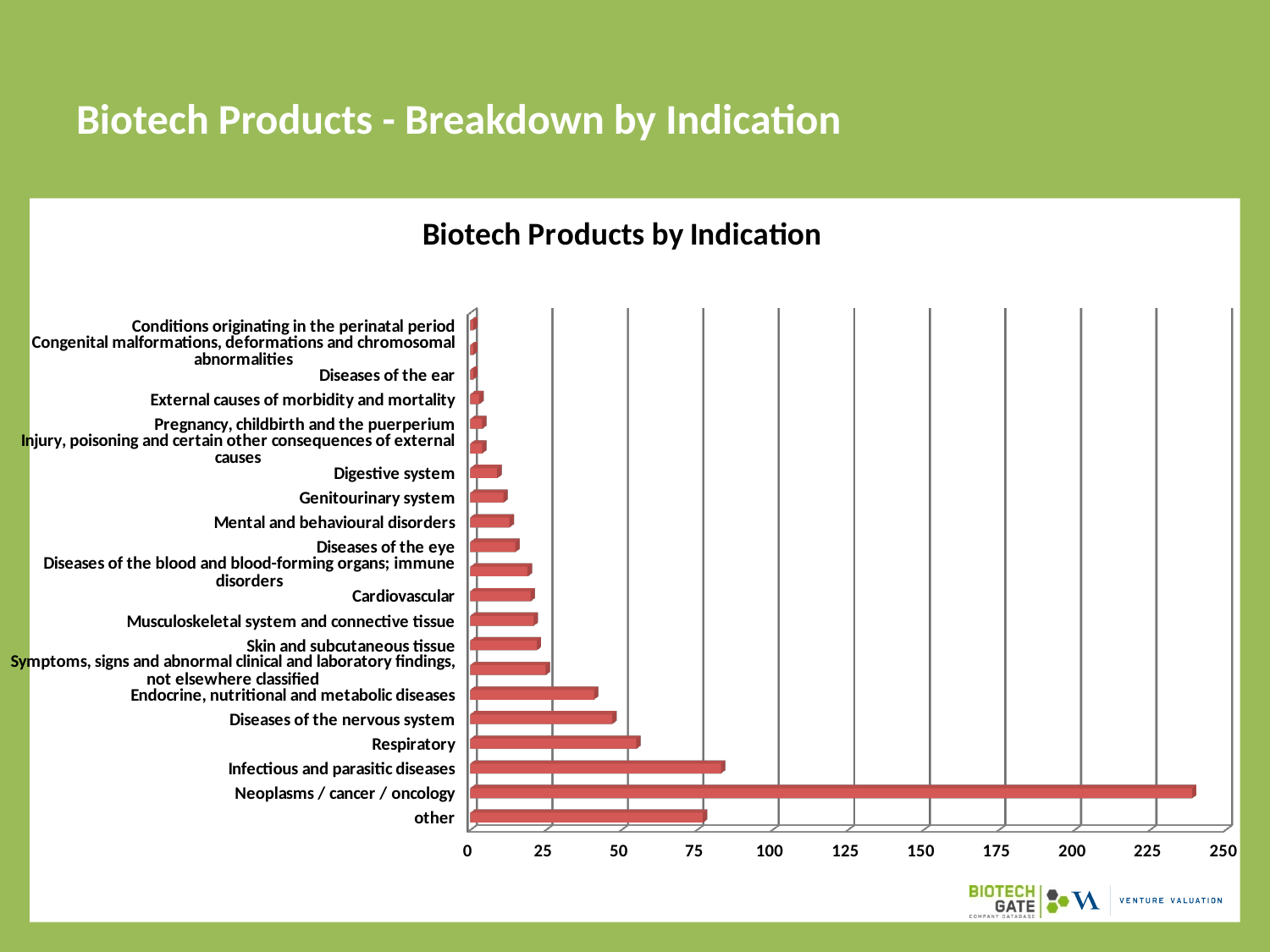
What kind of chart is shown on the slide? bar chart Which category has the highest value? Neoplasms / cancer / oncology Is the value for Respiratory greater or less than 50? greater Is the value for Endocrine, nutritional and metabolic diseases greater or less than 50? less What is the title of the chart? Biotech Products by Indication Which is larger, the value for Infectious and parasitic diseases or the value for Respiratory? Infectious and parasitic diseases Is the value for Neoplasms / cancer / oncology greater or less than 225? greater How many categories are plotted in the chart? 21 Which is larger, the value for Neoplasms / cancer / oncology or the value for other? Neoplasms / cancer / oncology